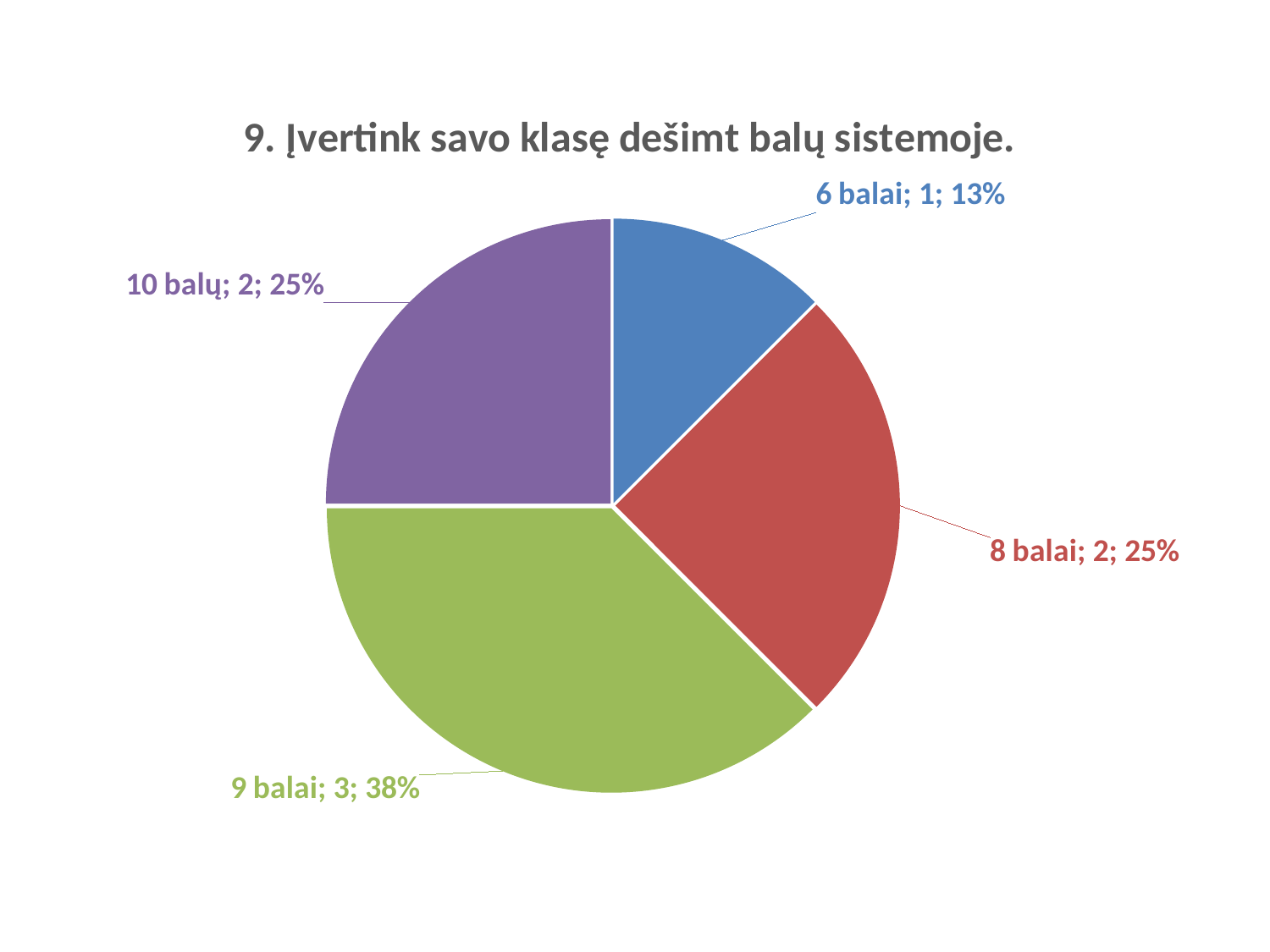
What is the value for "9 balai"? 3 Which category has the smallest slice? 6 balai Which category has the largest slice? 9 balai How many slices does the pie chart have? 4 What is the value for "6 balai"? 1 What kind of chart is shown on the slide? pie chart What is the difference between the values for "9 balai" and "6 balai"? 2 What share of the pie does "10 balų" take? 25% Which is larger, the value for "8 balai" or the value for "6 balai"? 8 balai What is the title of the chart? 9. Įvertink savo klasę dešimt balų sistemoje. What share of the pie does "9 balai" take? 38% What share of the pie does "6 balai" take? 13%